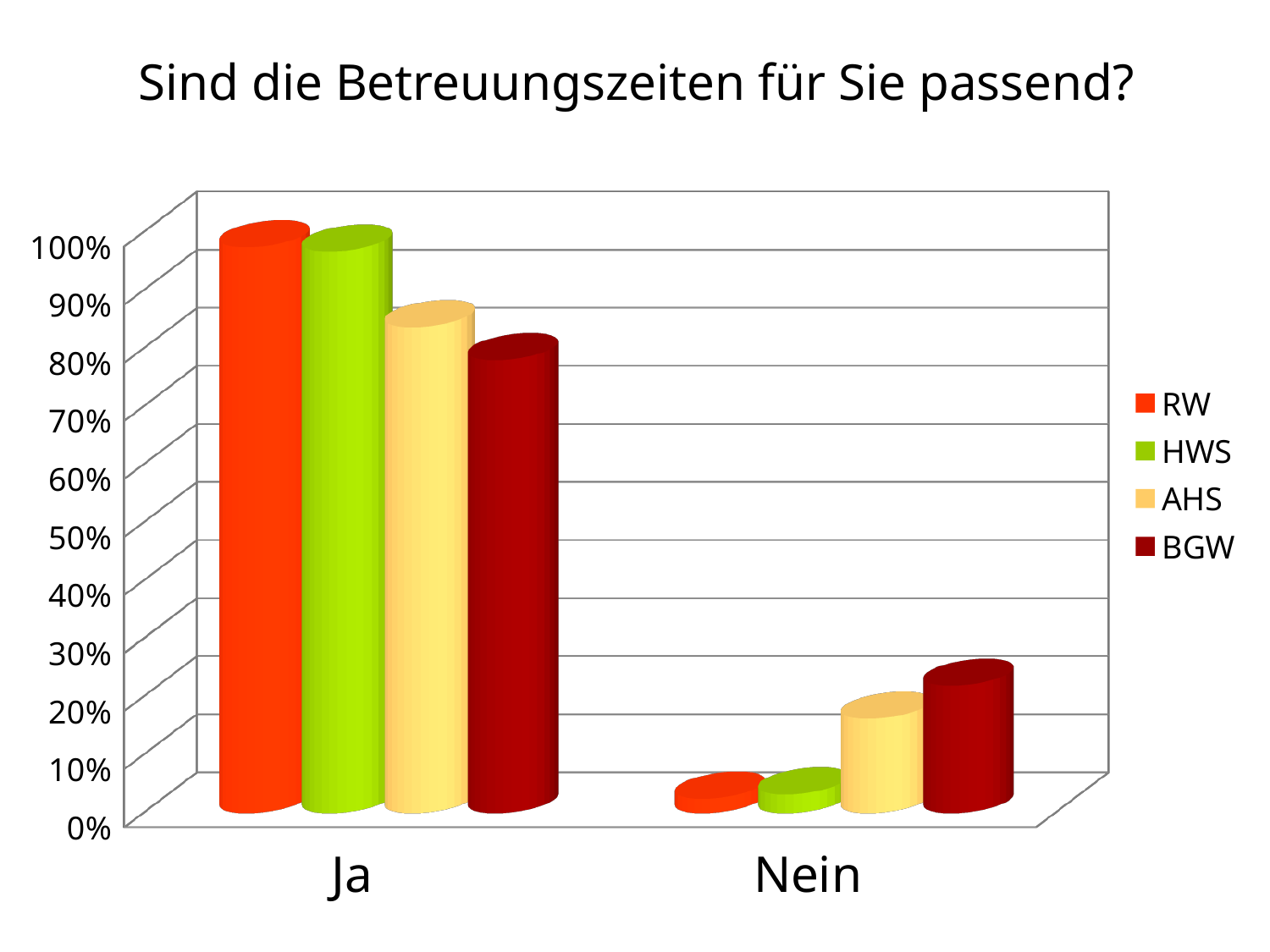
Which series is shown in dark red in the legend? BGW What is the title of the chart? Sind die Betreuungszeiten für Sie passend? In the Ja category, which is larger: the value for RW or the value for BGW? RW What kind of chart is shown on the slide? bar chart Which series has the highest value in the Nein category? BGW Is the value for RW in the Ja category greater or less than 90%? greater How many categories are shown on the x axis? 2 Which series has the lowest value in the Ja category? BGW Is the value for BGW in the Ja category greater or less than 90%? less Is the value for AHS in the Nein category greater or less than 30%? less How many series does the legend list? 4